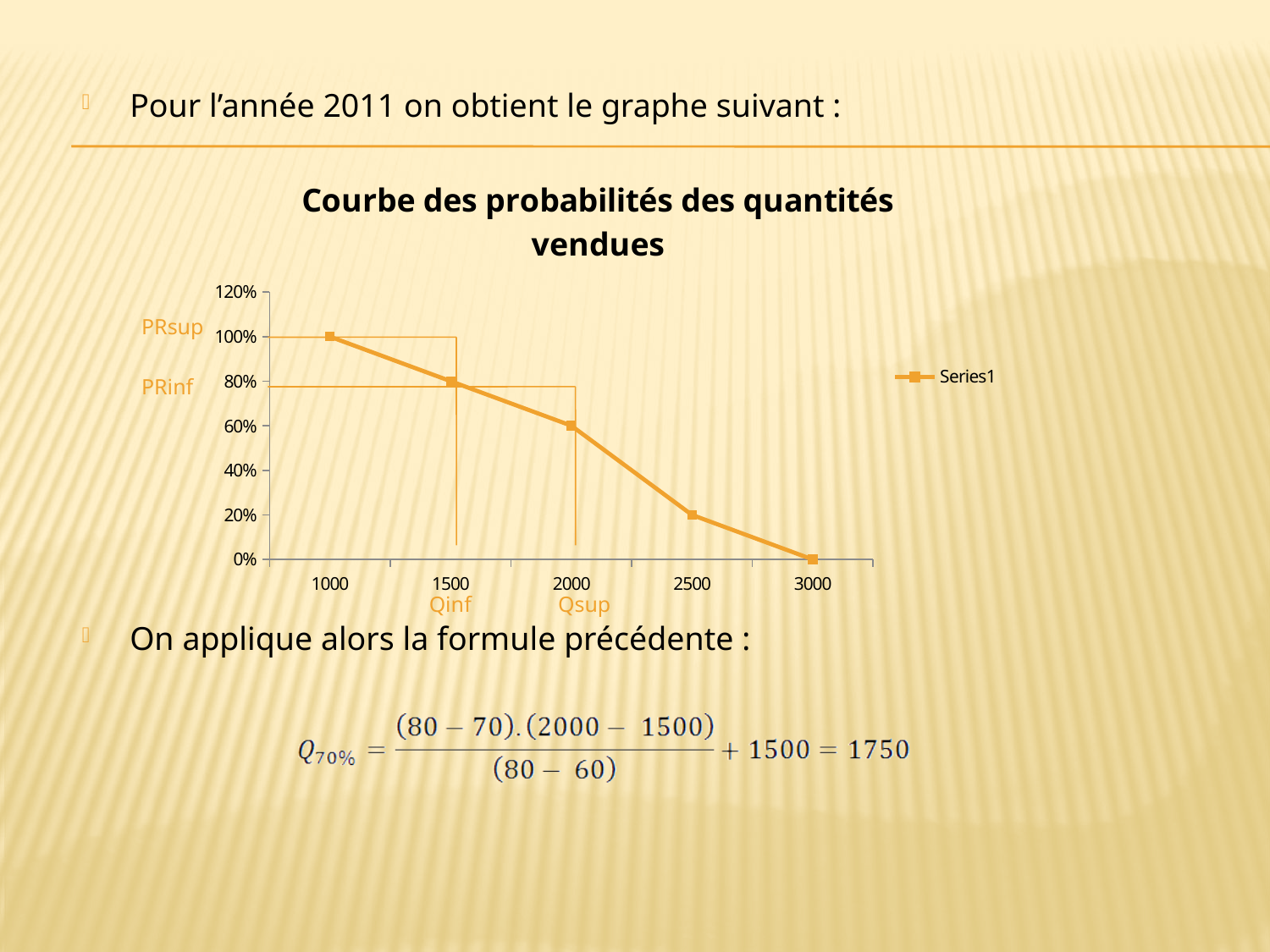
Do the values rise or fall as the x axis increases from 1000 to 3000? fall How many series does the legend list? 1 At which x value is the plotted value lowest? 3000 What is the value at 2000? 60% What kind of chart is shown on the slide? line chart What is the value at 1500? 80% What is the title of the chart? Courbe des probabilités des quantités vendues What is the value at 1000? 100% At which x value is the plotted value highest? 1000 What is the value at 3000? 0% How many data points are plotted on the line? 5 What is the difference between the value at 1500 and the value at 2500? 60%